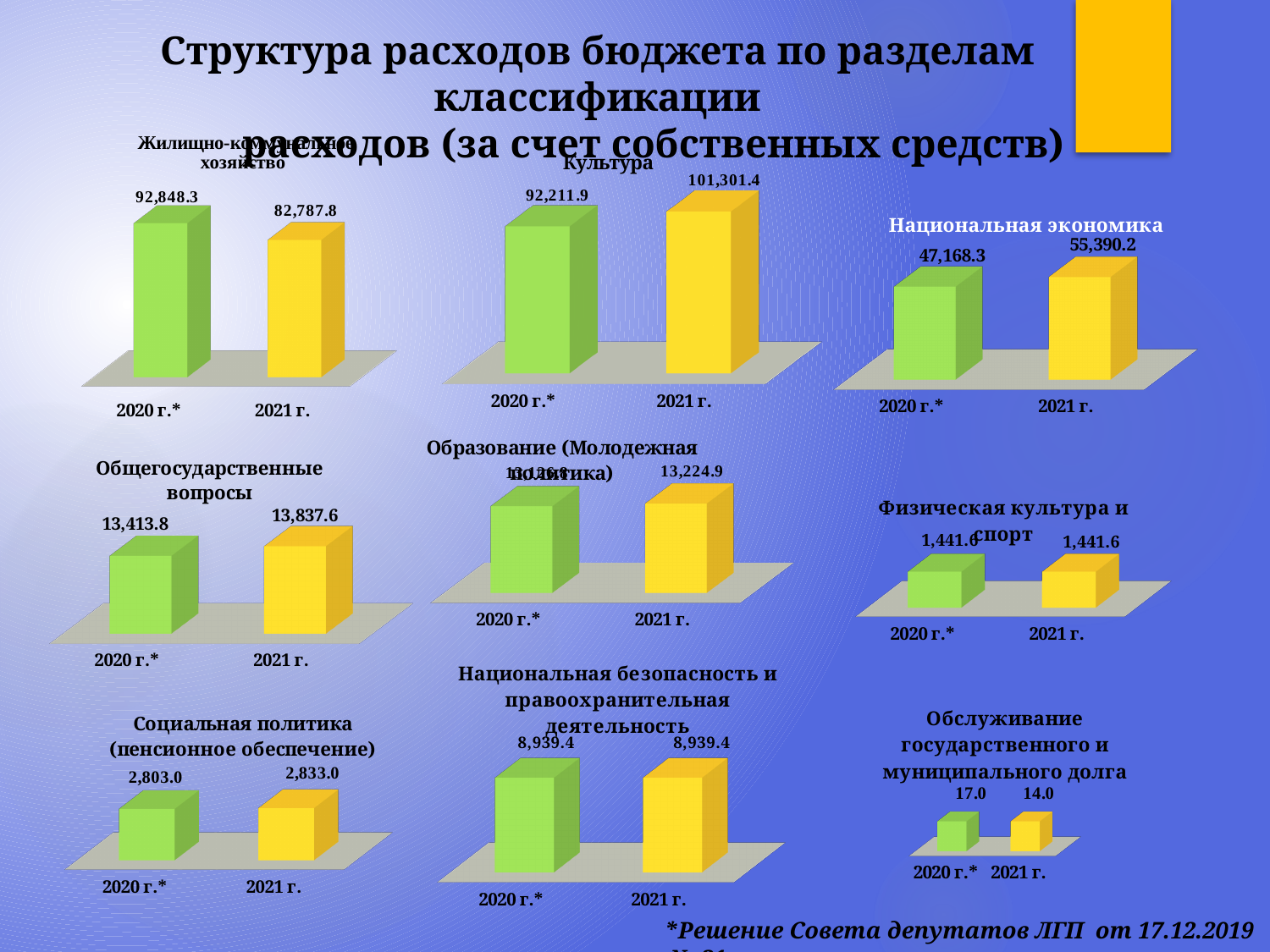
In the top-left chart (Жилищно-коммунальное хозяйство), what is the value for 2020 г.*? 92,848.3 In the Общегосударственные вопросы chart, which year has the higher value? 2021 г. In the Национальная экономика chart, what is the difference between the 2021 г. and 2020 г.* values? 8,221.9 In the Культура chart, what is the value for 2021 г.? 101,301.4 In the Физическая культура и спорт chart, what is the value for 2021 г.? 1,441.6 In the Обслуживание государственного и муниципального долга chart, what is the value for 2021 г.? 14.0 In the Социальная политика (пенсионное обеспечение) chart, what is the value for 2020 г.*? 2,803.0 In the Культура chart, do the values rise or fall from 2020 г.* to 2021 г.? rise What type of chart is used for Обслуживание государственного и муниципального долга? bar chart In the Национальная безопасность и правоохранительная деятельность chart, how many bars are plotted? 2 In the top-left chart (Жилищно-коммунальное хозяйство), do the values rise or fall from 2020 г.* to 2021 г.? fall In the Национальная экономика chart, what is the value for 2020 г.*? 47,168.3